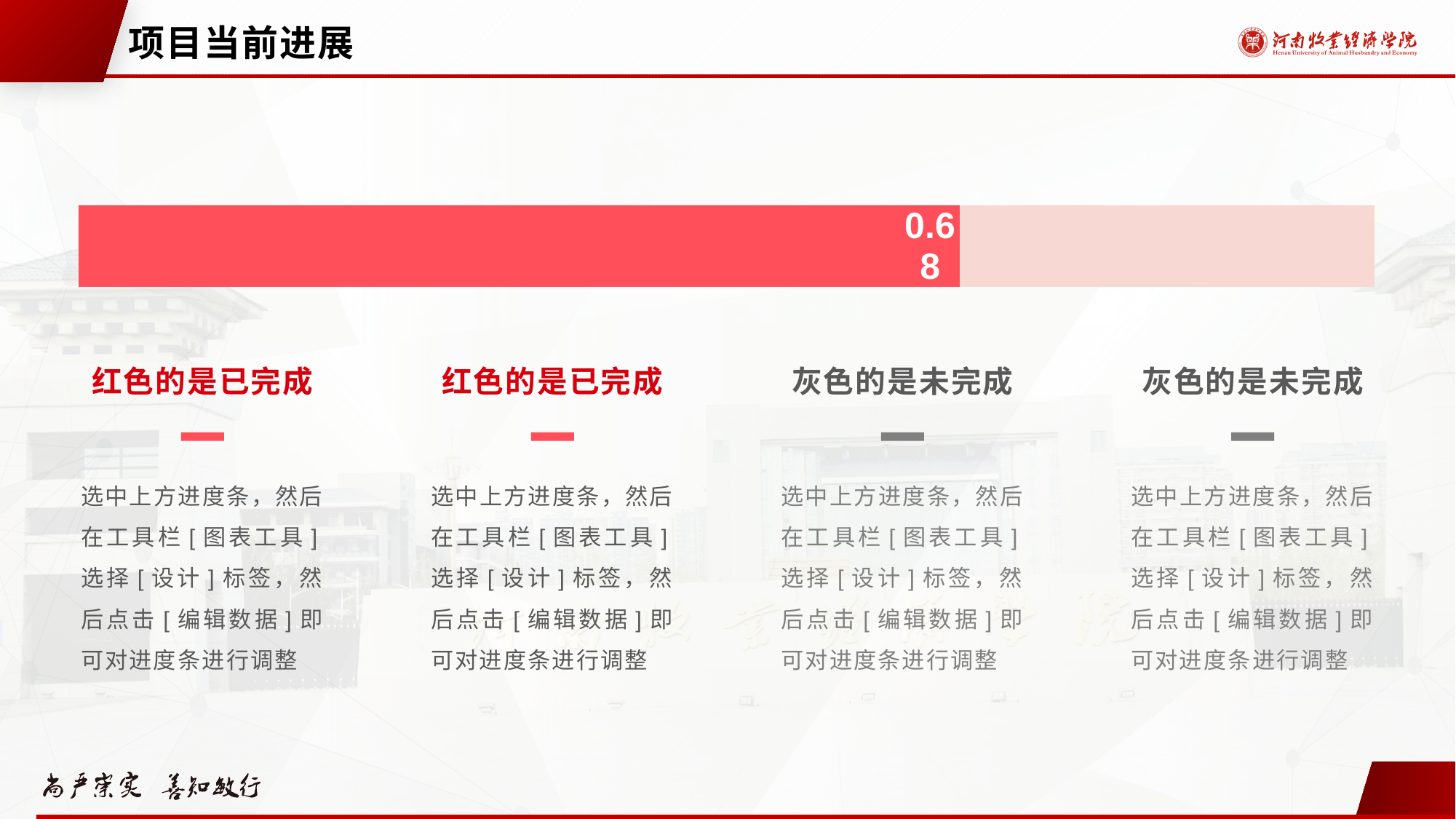
What is the title of the slide containing the progress bar? 项目当前进展 Is the value printed on the red segment greater or less than 0.5? greater What kind of chart is shown on the slide? bar chart How many bars does the chart contain? 1 According to the slide text, what does the red part of the bar represent? 已完成 (completed) What value is printed on the red (completed) segment of the progress bar? 0.68 Which segment of the bar is longer, the red segment or the light pink segment? the red segment